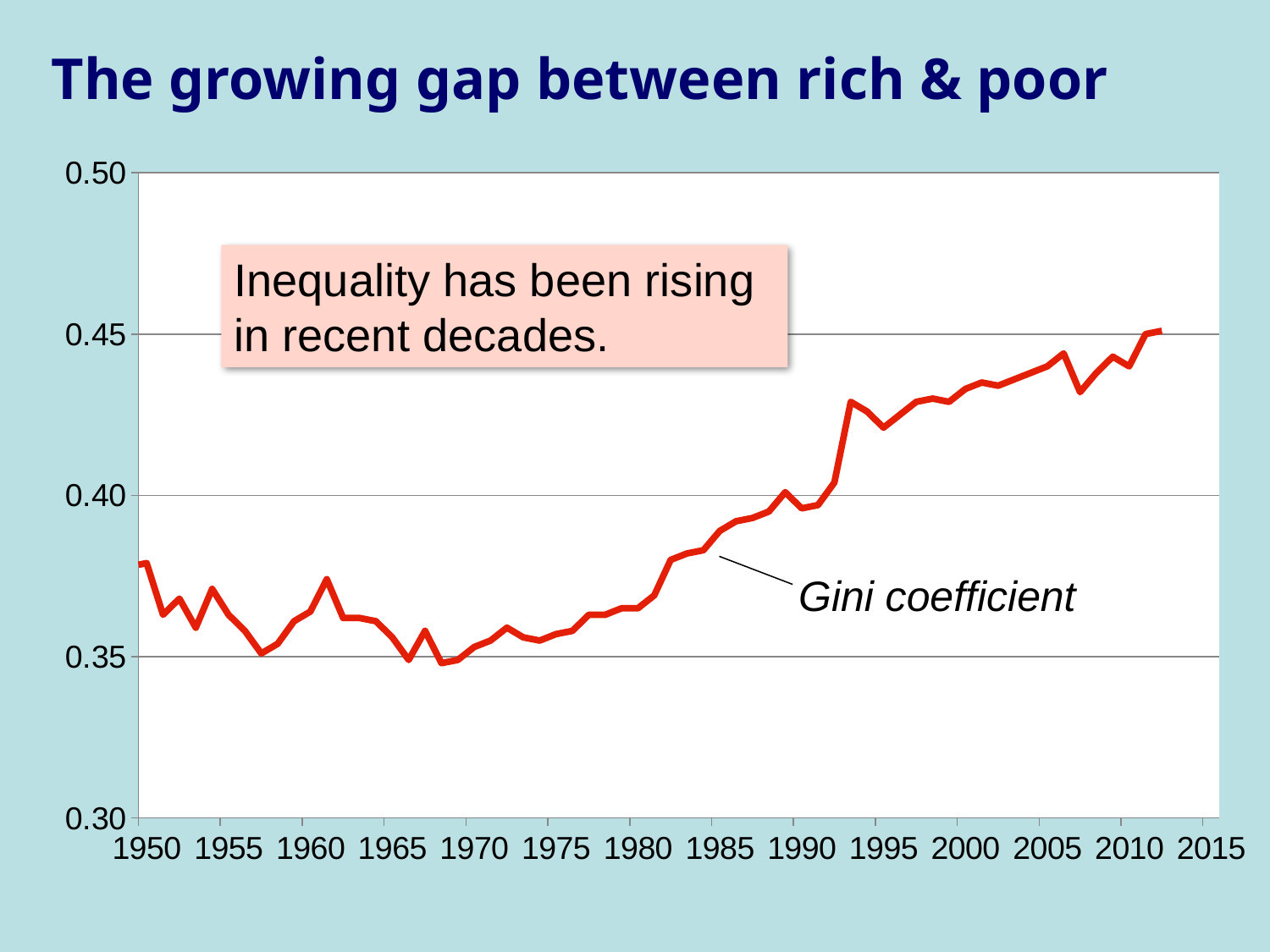
Is the Gini coefficient in 1960 greater or less than 0.40? less Is the Gini coefficient in 2000 greater or less than 0.40? greater Overall, does the Gini coefficient rise or fall between 1970 and 2010? rise What is the title of the slide containing the chart? The growing gap between rich & poor What kind of chart is shown on the slide? line chart Which year has the higher Gini coefficient, 1950 or 2010? 2010 Is the Gini coefficient in 1950 greater or less than 0.35? greater What series does the line on the chart represent? Gini coefficient Which year has the higher Gini coefficient, 1965 or 1995? 1995 How many data series are plotted on the chart? 1